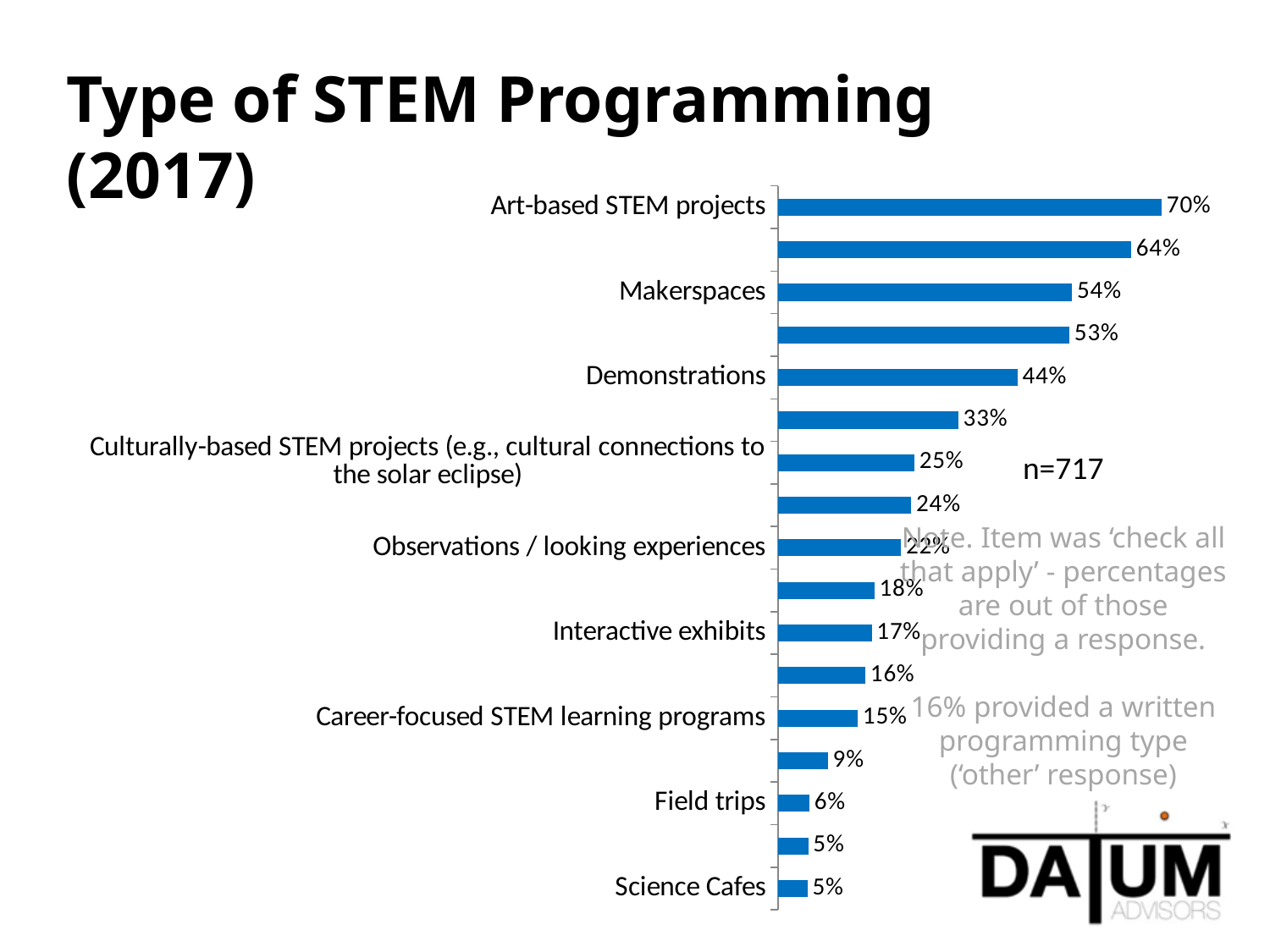
What percentage is shown for Field trips? 6% What percentage is shown for Interactive exhibits? 17% What percentage is shown for Demonstrations? 44% What is the difference in percentage points between Makerspaces and Demonstrations? 10 percentage points What percentage is shown for Culturally-based STEM projects? 25% What percentage is shown for Art-based STEM projects? 70% What sample size (n) is stated on the slide? n=717 What type of chart is shown on the slide? Bar chart How many bars are plotted in the chart? 17 What percentage is shown for Makerspaces? 54% Which has a higher percentage, Observations / looking experiences or Career-focused STEM learning programs? Observations / looking experiences Which category has the highest percentage? Art-based STEM projects